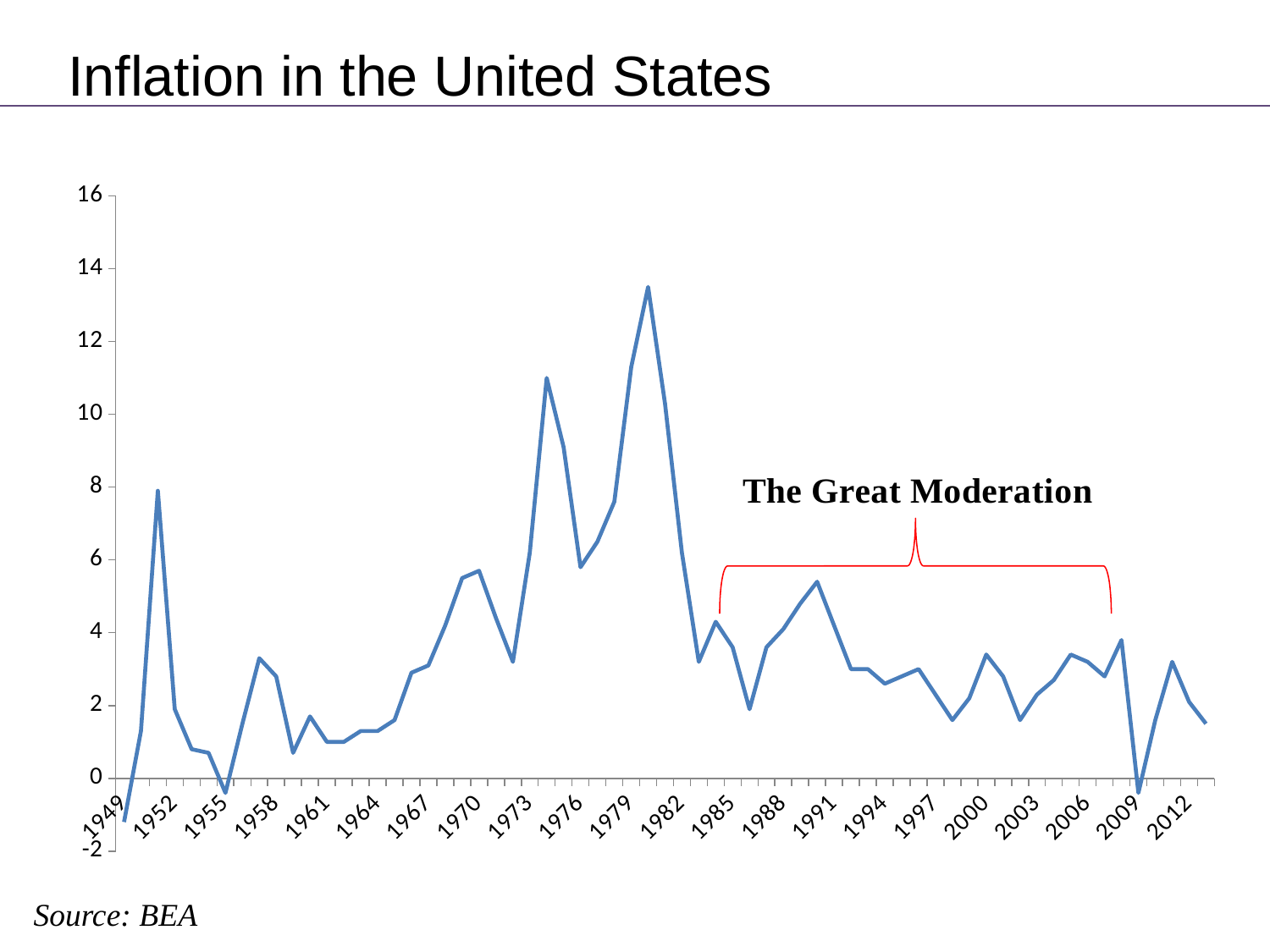
Do the values rise or fall between 1982 and 1985? fall Is the value for 2009 greater or less than 0? less What is the title of the chart on the slide? Inflation in the United States What kind of chart is shown on the slide? line chart Which year has the larger value, 1976 or 1985? 1976 Do the values rise or fall between 1949 and 1952 up to the first peak? rise Which year has the larger value, 1970 or 2000? 1970 Is the value for 1979 greater or less than 10? greater Is the value for 1952 greater or less than 4? less What label is written above the red bracket on the chart? The Great Moderation